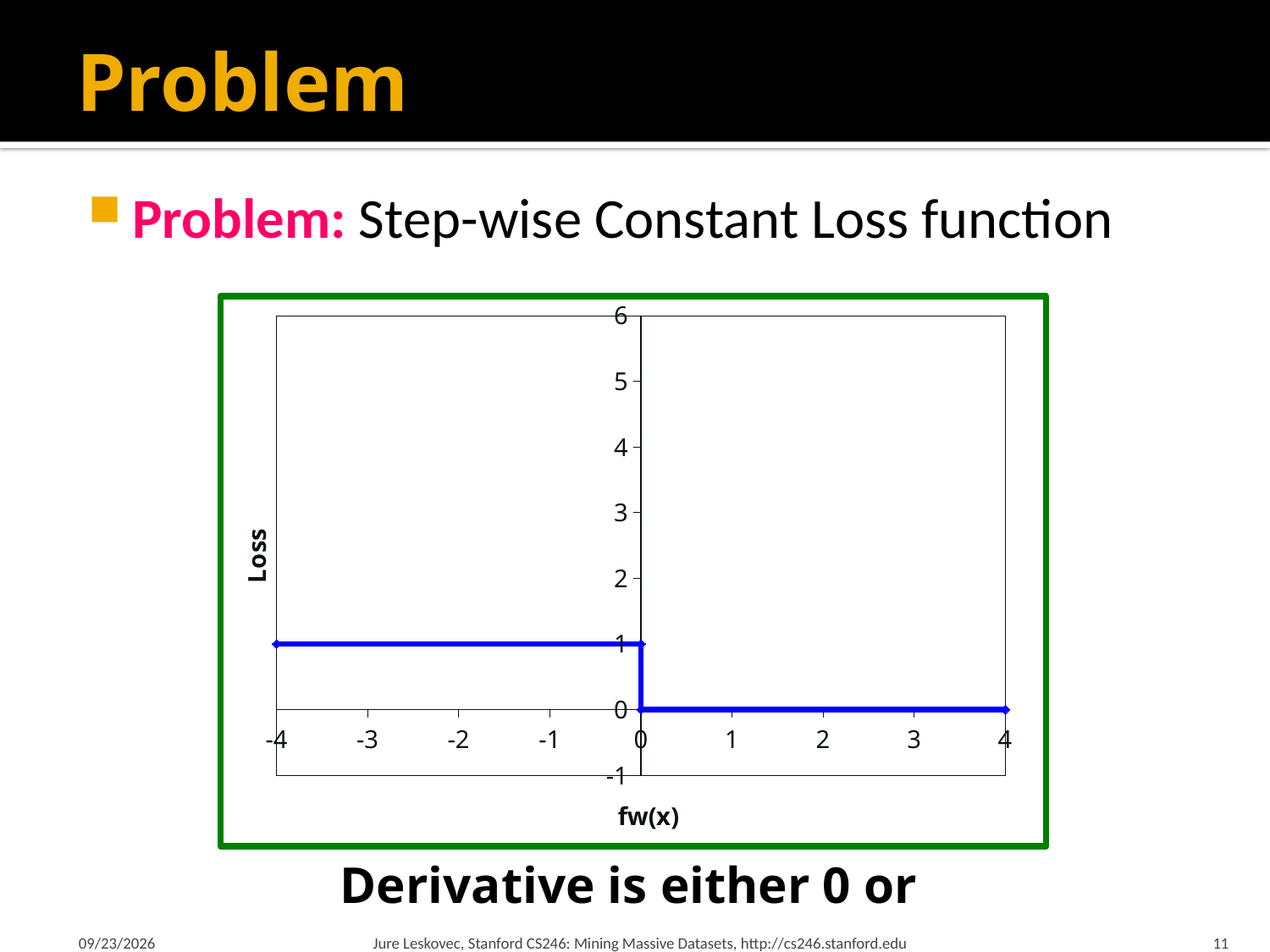
What is the difference between the Loss at fw(x) = -3 and the Loss at fw(x) = 3? 1 What is the label of the vertical axis? Loss Is the Loss at fw(x) = -3 greater or less than 3? less What is the Loss value when fw(x) is 2? 0 What is the Loss value when fw(x) is -4? 1 As fw(x) increases from -4 to 4, does the Loss rise or fall? fall What is the Loss value when fw(x) is 4? 0 What kind of chart is shown on the slide? line chart What is the label of the horizontal axis? fw(x) What is the Loss value when fw(x) is -2? 1 Which is larger, the Loss at fw(x) = -1 or the Loss at fw(x) = 1? fw(x) = -1 At what value of fw(x) does the Loss drop from 1 to 0? 0